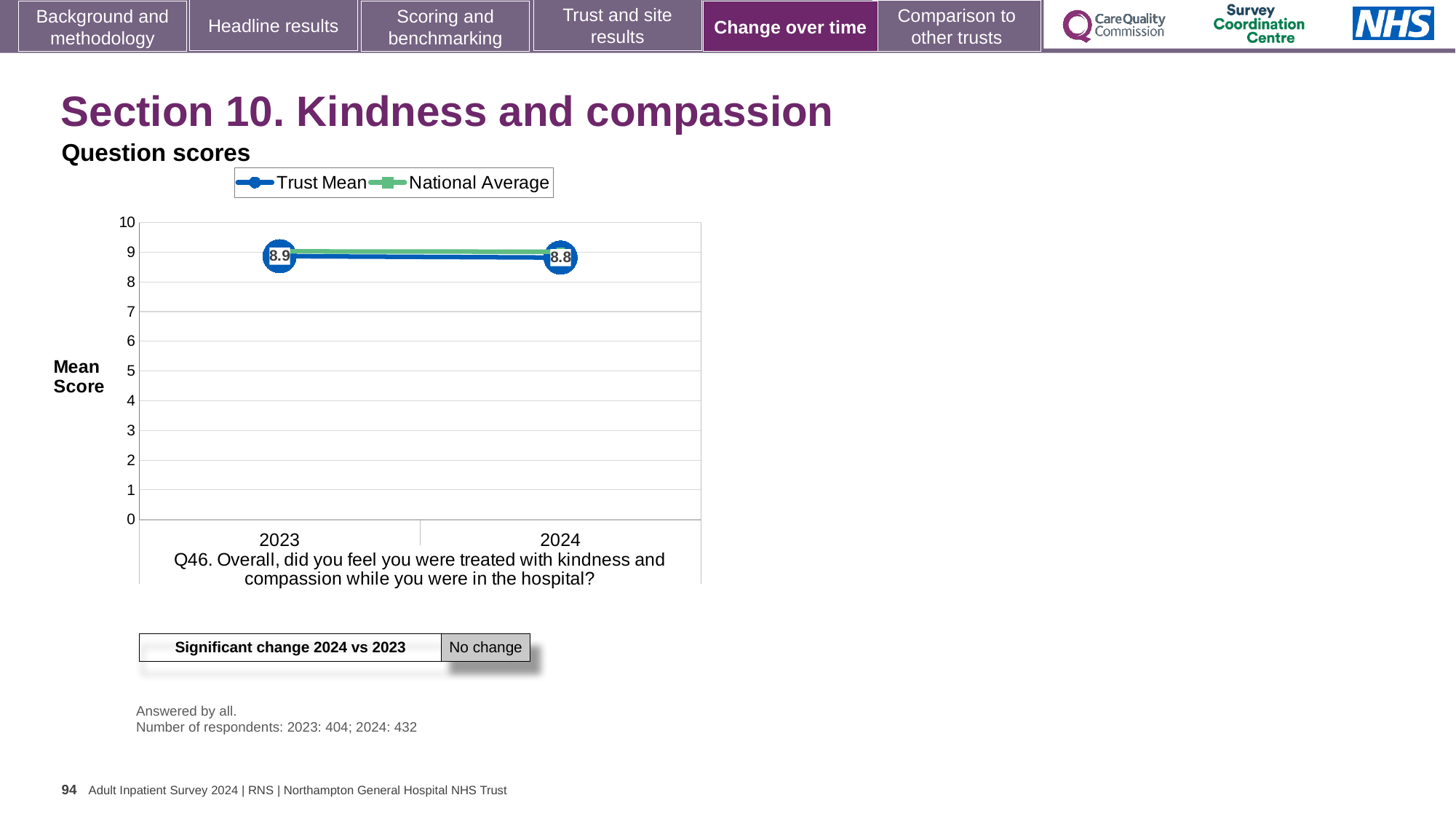
What is the difference between the Trust Mean scores for 2023 and 2024? 0.1 Which year has the higher Trust Mean score, 2023 or 2024? 2023 How many series does the chart legend list? 2 What are the two series named in the chart legend? Trust Mean and National Average Is the National Average value for 2024 greater or less than 5? greater Is the Trust Mean value for 2023 greater or less than 8? greater How many years are shown on the x axis of the chart? 2 What type of chart is shown on the slide? line chart Does the Trust Mean rise or fall from 2023 to 2024? fall What is the Trust Mean score for 2023? 8.9 What is the label on the y axis of the chart? Mean Score What is the Trust Mean score for 2024? 8.8